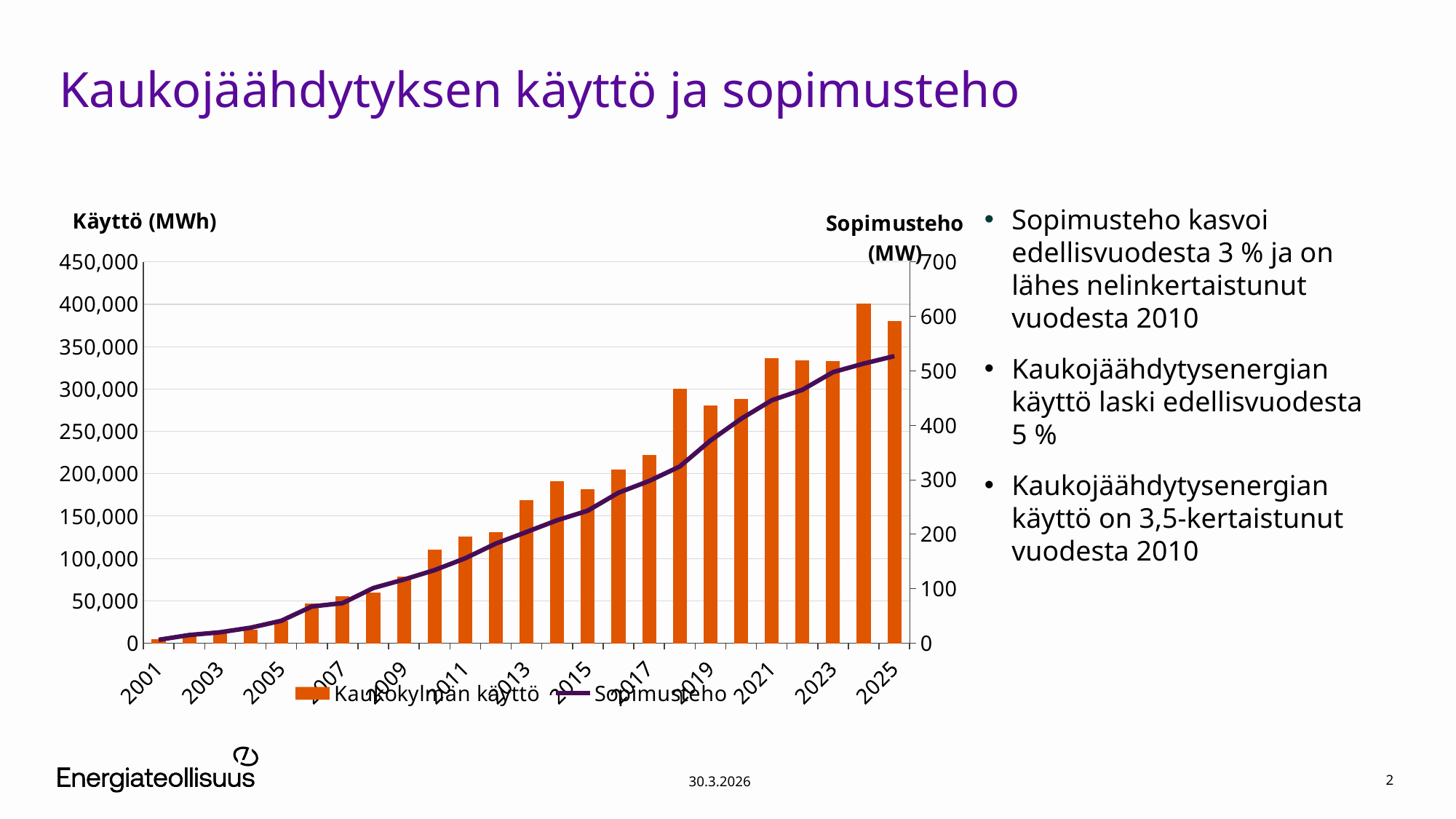
What is the title of the left vertical axis of the chart? Käyttö (MWh) Does the Sopimusteho line generally rise or fall from 2001 to 2025? Rise What kind of chart is shown on the slide? A combined bar and line chart Is the Kaukokylmän käyttö value for 2001 greater or less than 50,000? less How many series does the chart legend list? 2 What are the two series named in the chart legend? Kaukokylmän käyttö and Sopimusteho Is the Kaukokylmän käyttö value for 2025 greater or less than 350,000? greater Is the Sopimusteho value for 2011 greater or less than 200? less Which year has the larger Kaukokylmän käyttö value, 2019 or 2021? 2021 Which year has the lowest Kaukokylmän käyttö bar? 2001